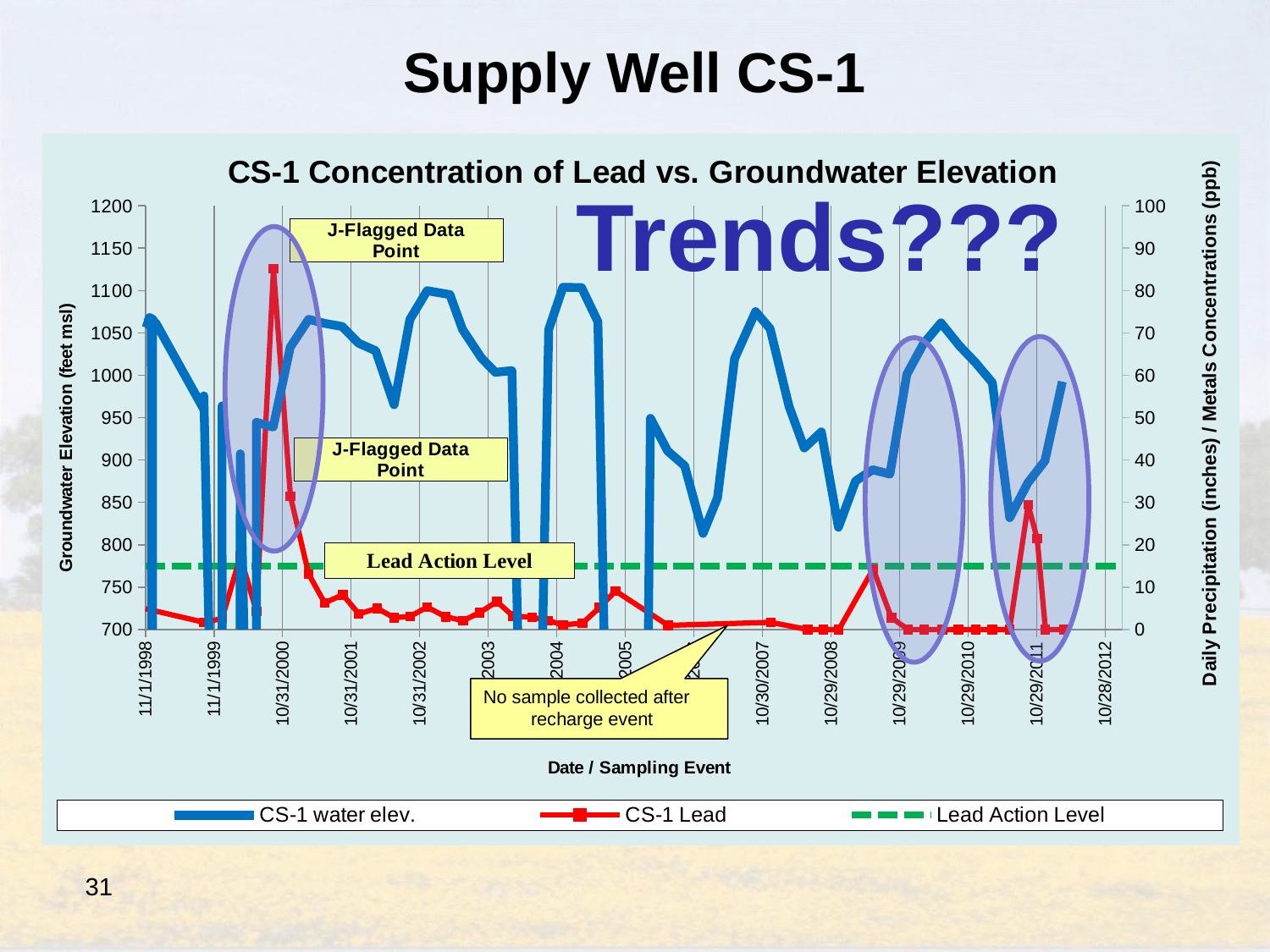
Is the CS-1 water elevation at 11/1/1998 greater or less than 1000 feet msl? greater Around which date does the CS-1 Lead series reach its highest value? 10/31/2000 Is the CS-1 water elevation near 10/29/2008 greater or less than 900 feet msl? less How many series does the legend list? 3 What is the title of the chart? CS-1 Concentration of Lead vs. Groundwater Elevation What kind of chart is shown on the slide? line chart Does the CS-1 Lead series rise or fall between 10/31/2000 and 10/31/2001? fall Is the Lead Action Level greater or less than 10 on the right-hand axis? greater Which series is drawn as a green dashed line? Lead Action Level Which is larger: the CS-1 Lead peak near 10/31/2000 or the CS-1 Lead peak near 10/29/2011? 10/31/2000